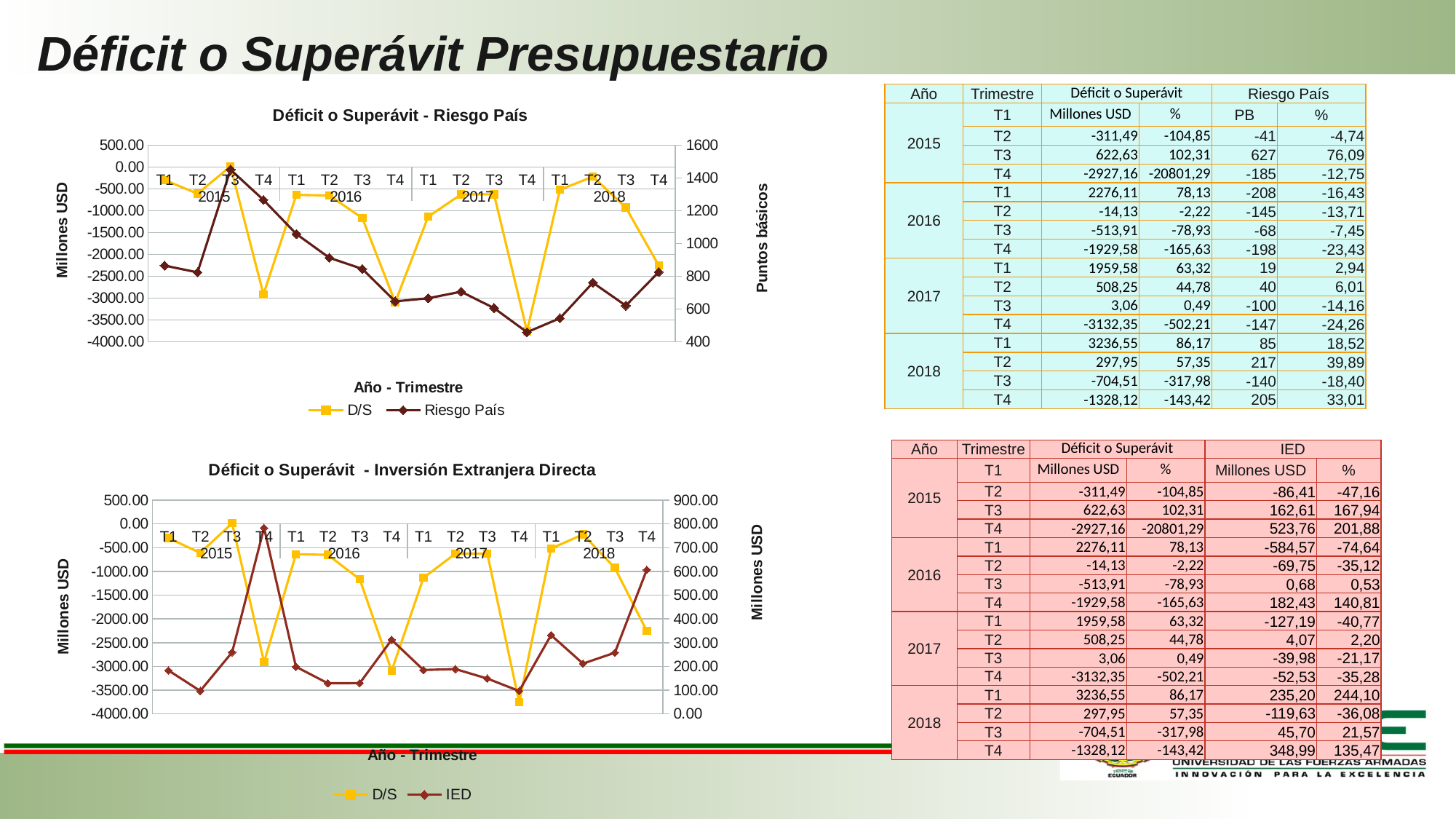
In the 'Déficit o Superávit - Inversión Extranjera Directa' chart, which is larger, the IED value for 2016 T4 or for 2017 T1? 2016 T4 What is the label of the right-hand vertical axis of the 'Déficit o Superávit - Riesgo País' chart? Puntos básicos In the 'Déficit o Superávit - Riesgo País' chart, which quarter has the lowest Riesgo País value? 2017 T4 In the 'Déficit o Superávit - Riesgo País' chart, how many quarterly points are plotted along the x axis? 16 In the 'Déficit o Superávit - Riesgo País' chart, is the Riesgo País value for 2016 T1 greater or less than 1000? greater In the 'Déficit o Superávit - Inversión Extranjera Directa' chart, which quarter has the highest IED value? 2015 T4 In the 'Déficit o Superávit - Riesgo País' chart, is the D/S value for 2015 T4 greater or less than -2500.00? less What type of chart is the 'Déficit o Superávit - Riesgo País' chart? Line chart In the 'Déficit o Superávit - Riesgo País' chart, which quarter has the highest Riesgo País value? 2015 T3 How many series does the legend of the 'Déficit o Superávit - Inversión Extranjera Directa' chart list? 2 In the 'Déficit o Superávit - Inversión Extranjera Directa' chart, is the IED value for 2018 T4 greater or less than 500.00? greater In the 'Déficit o Superávit - Riesgo País' chart, does the Riesgo País series rise or fall from 2016 T1 to 2016 T4? Fall